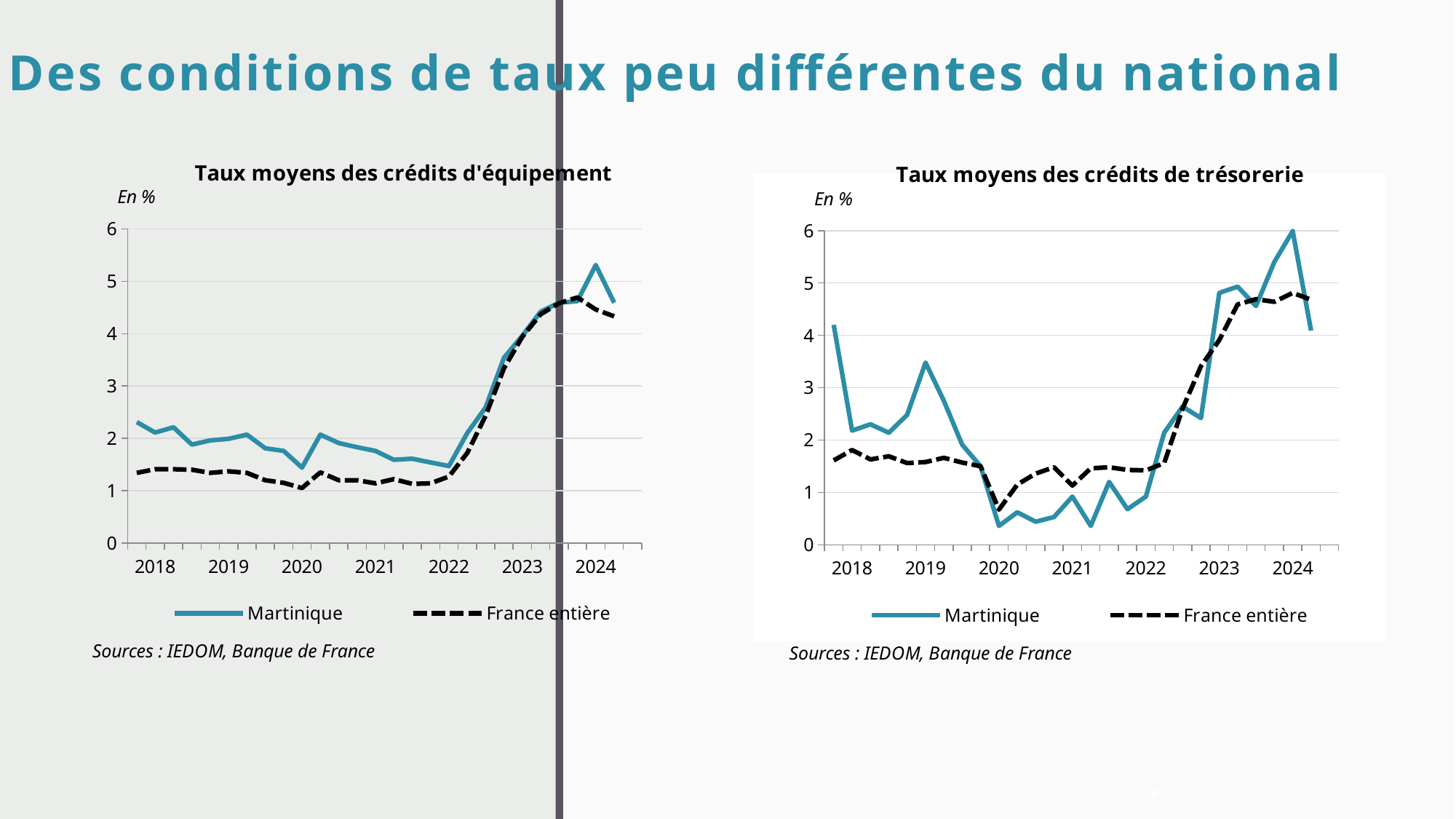
What unit is indicated on the y axis of 'Taux moyens des crédits de trésorerie'? En % In 'Taux moyens des crédits d'équipement', which series is higher at the start of 2018, Martinique or France entière? Martinique In 'Taux moyens des crédits de trésorerie', which series is higher at the start of 2018, Martinique or France entière? Martinique What kind of chart is 'Taux moyens des crédits d'équipement'? line chart In 'Taux moyens des crédits d'équipement', does the Martinique series rise or fall overall between 2018 and 2022? fall In 'Taux moyens des crédits d'équipement', is the Martinique value at the start of 2018 greater or less than 2? greater In 'Taux moyens des crédits de trésorerie', does the Martinique series rise or fall between 2022 and 2023? rise In 'Taux moyens des crédits d'équipement', which series is shown as a dashed line? France entière In 'Taux moyens des crédits de trésorerie', is the Martinique value at the start of 2020 greater or less than 1? less How many series does the legend of 'Taux moyens des crédits de trésorerie' list? 2 In 'Taux moyens des crédits d'équipement', is the France entière value at the start of 2018 greater or less than 2? less